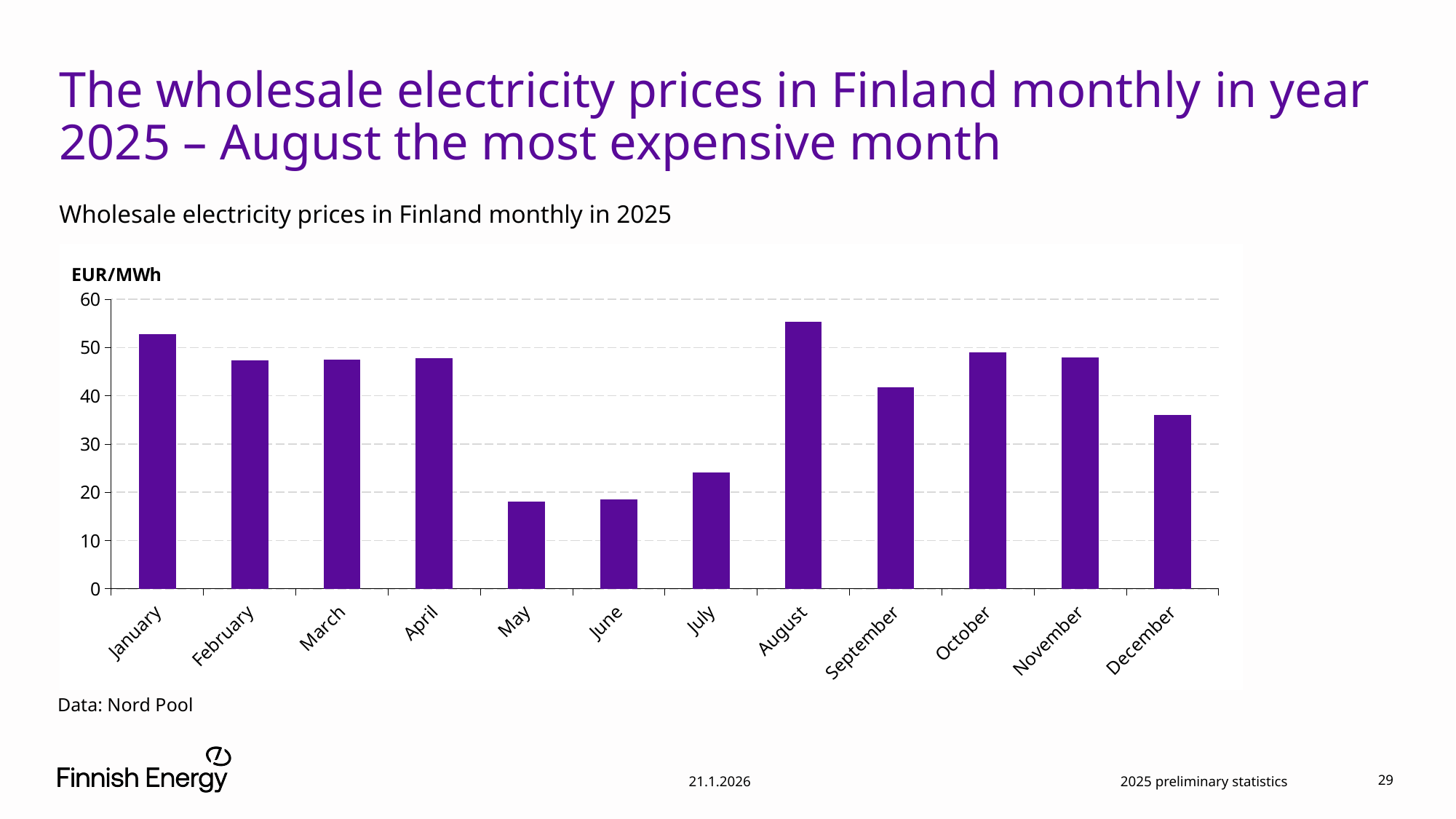
Is the value for July greater or less than 30? less What unit is shown on the vertical axis of the chart? EUR/MWh What kind of chart is shown on the slide? bar chart Is the value for December greater or less than 40? less Which month has the highest wholesale electricity price in the chart? August Is the value for August greater or less than 50? greater Which month has the lowest wholesale electricity price in the chart? May How many months are shown in the chart? 12 Which is larger, the value for June or the value for July? July Which is larger, the value for September or the value for October? October